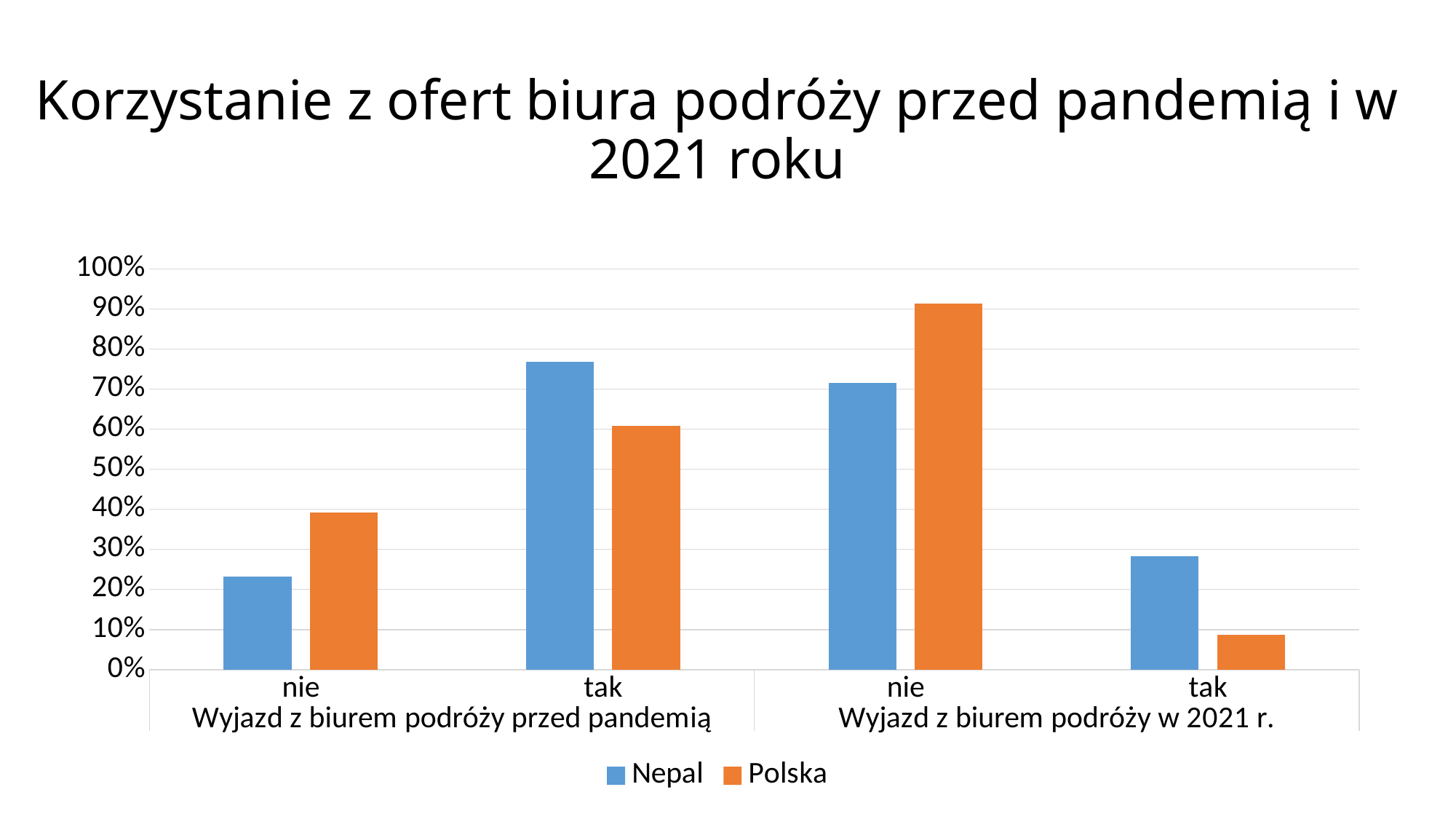
What kind of chart is shown on the slide? bar chart Which bar is the highest on the chart? Polska, nie, Wyjazd z biurem podróży w 2021 r. Is the value for Nepal under 'nie' in 'Wyjazd z biurem podróży przed pandemią' greater or less than 30%? less What are the two series named in the legend? Nepal and Polska Is the value for Polska under 'nie' in 'Wyjazd z biurem podróży w 2021 r.' greater or less than 90%? greater How many series does the legend list? 2 How many bars are plotted in total on the chart? 8 Is the value for Nepal under 'tak' in 'Wyjazd z biurem podróży przed pandemią' greater or less than 70%? greater Which bar is the lowest on the chart? Polska, tak, Wyjazd z biurem podróży w 2021 r. Under 'tak' in 'Wyjazd z biurem podróży przed pandemią', which series has the larger value, Nepal or Polska? Nepal What is the title of the chart? Korzystanie z ofert biura podróży przed pandemią i w 2021 roku